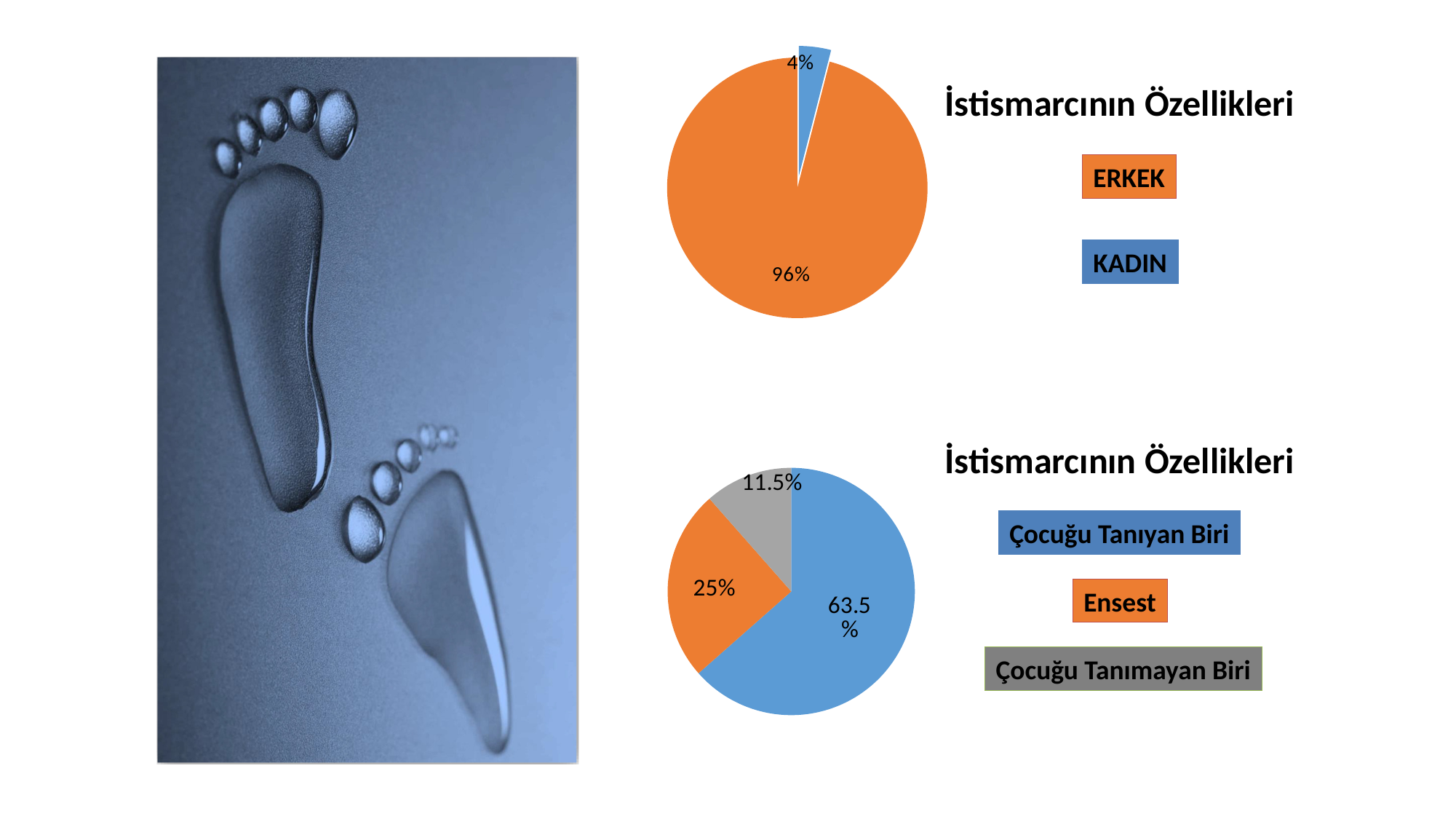
In the bottom pie chart, what is the difference between the Ensest and Çocuğu Tanımayan Biri shares? 13.5% In the top pie chart, what share is labelled for KADIN? 4% What type of chart is the top chart on the slide? Pie chart How many slices does the top pie chart have? 2 In the top pie chart, which category has the larger slice, ERKEK or KADIN? ERKEK In the bottom pie chart, which category has the smallest slice? Çocuğu Tanımayan Biri In the top pie chart, what share is labelled for ERKEK? 96% In the bottom pie chart, what share is labelled for Çocuğu Tanıyan Biri? 63.5% In the bottom pie chart, which colour represents Ensest? Orange In the bottom pie chart, what share is labelled for Çocuğu Tanımayan Biri? 11.5% In the bottom pie chart, what share is labelled for Ensest? 25% In the top pie chart, what is the difference between the ERKEK and KADIN shares? 92%